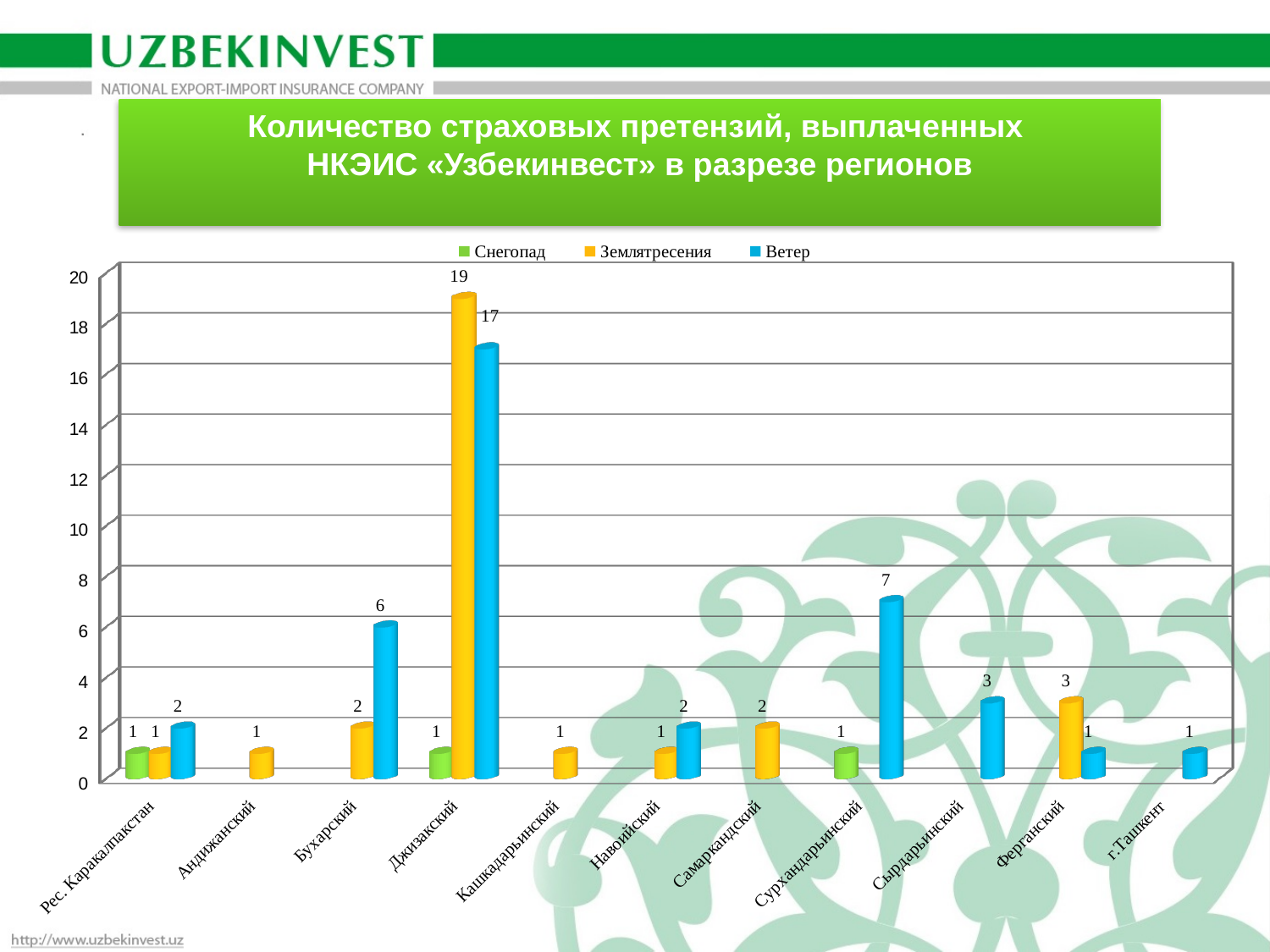
Is the Ветер value for Джизакский greater or less than 10? greater What is the value of Землятресения for Джизакский? 19 Which region has the highest value for Землятресения? Джизакский What type of chart is shown on the slide? bar chart How many regions (categories) are shown on the x axis? 11 What is the value of Ветер for Джизакский? 17 What is the difference between the Землятресения and Ветер values for Джизакский? 2 What is the value of Ветер for Бухарский? 6 What is the value of Ветер for Сурхандарьинский? 7 Which is larger for Ферганский: Землятресения or Ветер? Землятресения How many series does the legend list? 3 Which series is shown in green in the legend? Снегопад